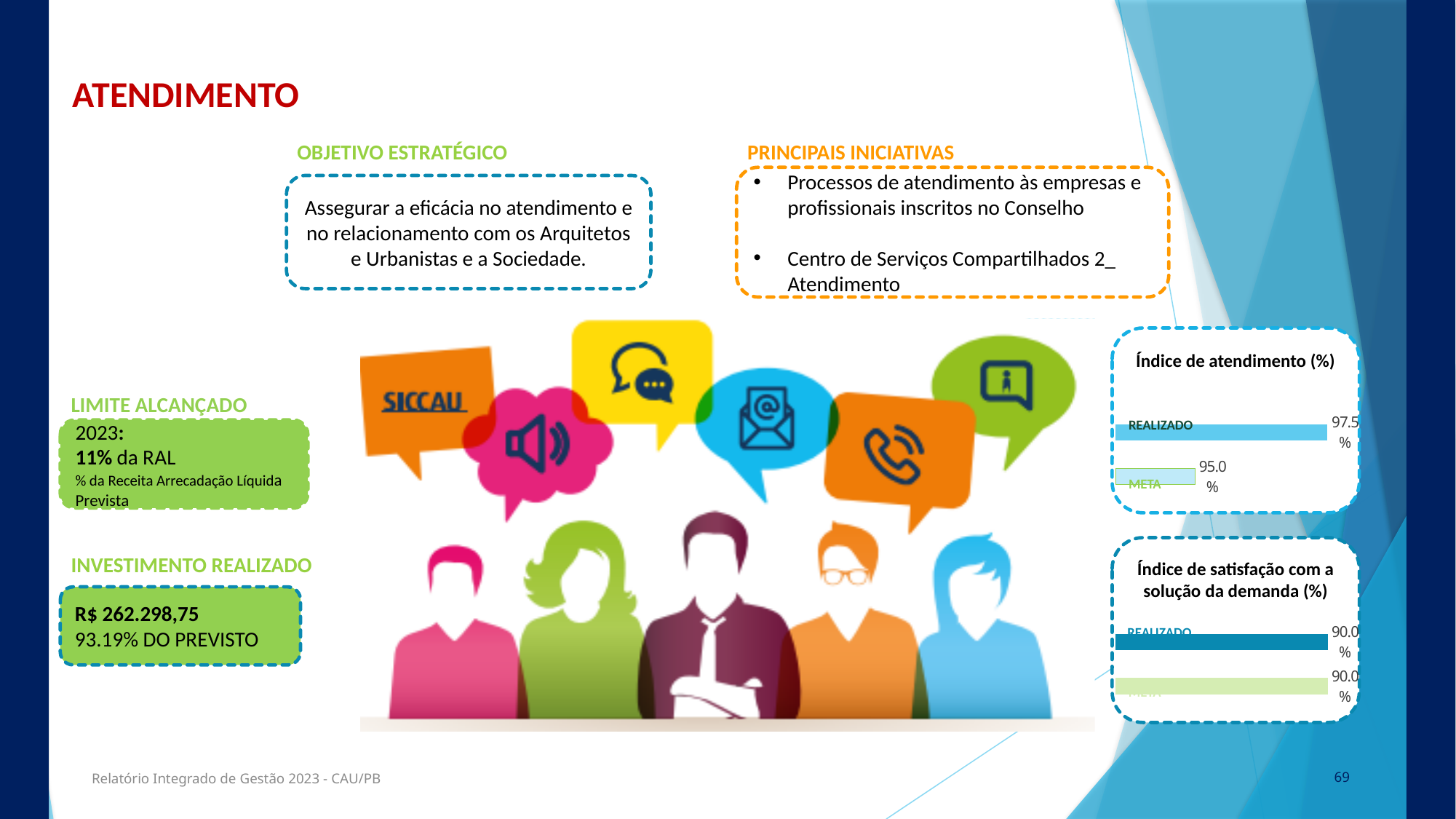
In the 'Índice de atendimento (%)' chart, what is the difference between REALIZADO and META? 2.5% How many bars are shown in the 'Índice de atendimento (%)' chart? 2 In the 'Índice de satisfação com a solução da demanda (%)' chart, what is the value for META? 90.0% In the 'Índice de atendimento (%)' chart, which category has the lower value? META What kind of chart is the 'Índice de satisfação com a solução da demanda (%)' chart? bar chart In the 'Índice de atendimento (%)' chart, which category has the higher value? REALIZADO In the 'Índice de satisfação com a solução da demanda (%)' chart, what is the difference between REALIZADO and META? 0.0% What is the title of the upper chart on the right side of the slide? Índice de atendimento (%) In the 'Índice de satisfação com a solução da demanda (%)' chart, what is the value for REALIZADO? 90.0% In the 'Índice de atendimento (%)' chart, is REALIZADO larger or smaller than META? larger In the 'Índice de atendimento (%)' chart, what is the value for META? 95.0% In the 'Índice de atendimento (%)' chart, what is the value for REALIZADO? 97.5%